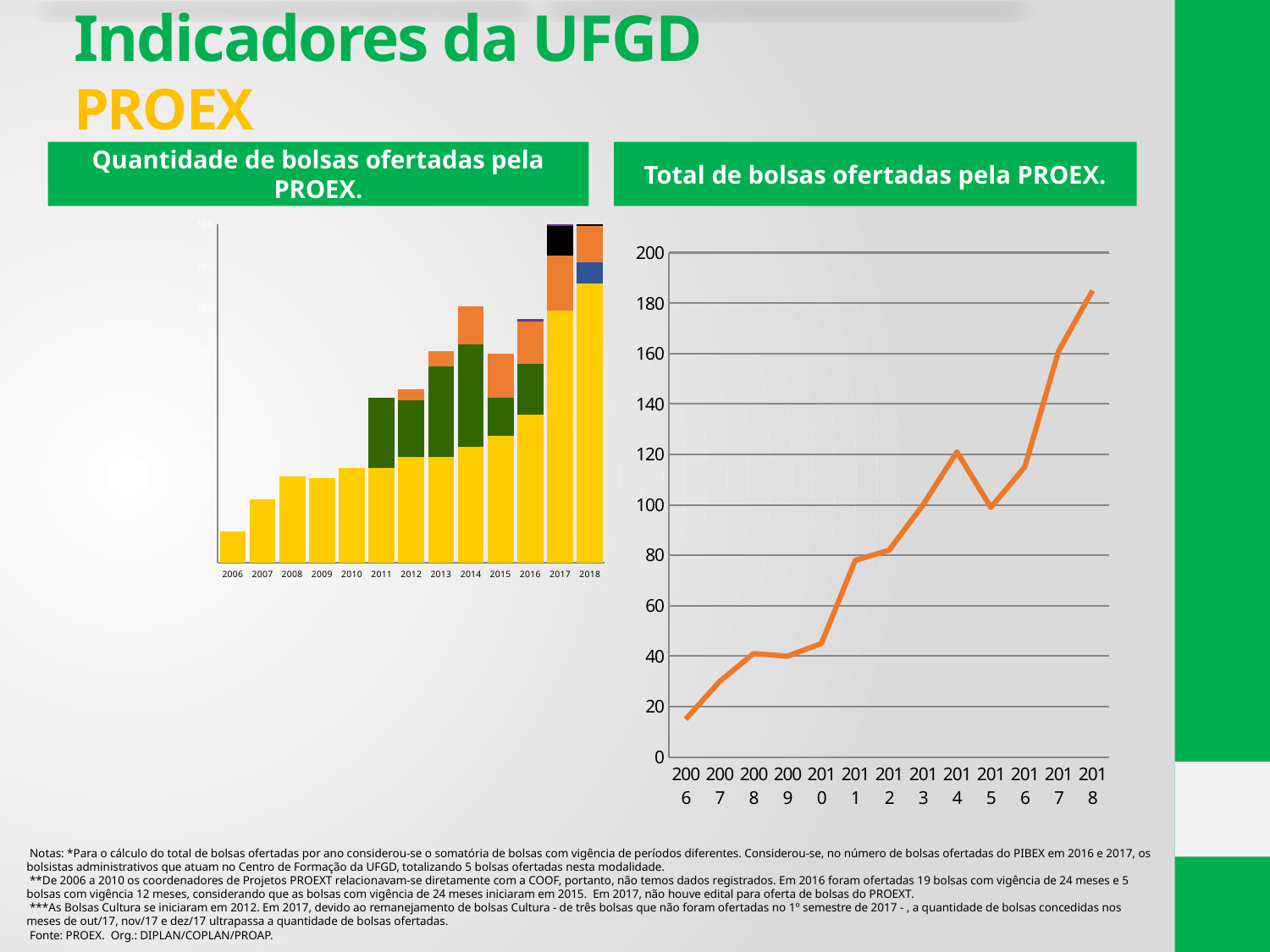
In the chart "Total de bolsas ofertadas pela PROEX.", is the value for 2006 greater or less than 20? less What kind of chart is the chart titled "Total de bolsas ofertadas pela PROEX."? line chart In the chart "Quantidade de bolsas ofertadas pela PROEX.", how many years are shown on the x axis? 13 In the chart "Total de bolsas ofertadas pela PROEX.", which year has the highest value? 2018 In the chart "Quantidade de bolsas ofertadas pela PROEX.", which year has the shortest bar? 2006 In the chart "Total de bolsas ofertadas pela PROEX.", is the value for 2009 greater or less than 60? less In the chart "Total de bolsas ofertadas pela PROEX.", is the value for 2018 greater or less than 180? greater In the chart "Total de bolsas ofertadas pela PROEX.", which year has the larger value, 2014 or 2015? 2014 In the chart "Total de bolsas ofertadas pela PROEX.", do the values generally rise or fall from 2006 to 2018? rise In the chart "Total de bolsas ofertadas pela PROEX.", which year has the lowest value? 2006 What kind of chart is the chart titled "Quantidade de bolsas ofertadas pela PROEX."? bar chart In the chart "Total de bolsas ofertadas pela PROEX.", how many years are shown on the x axis? 13